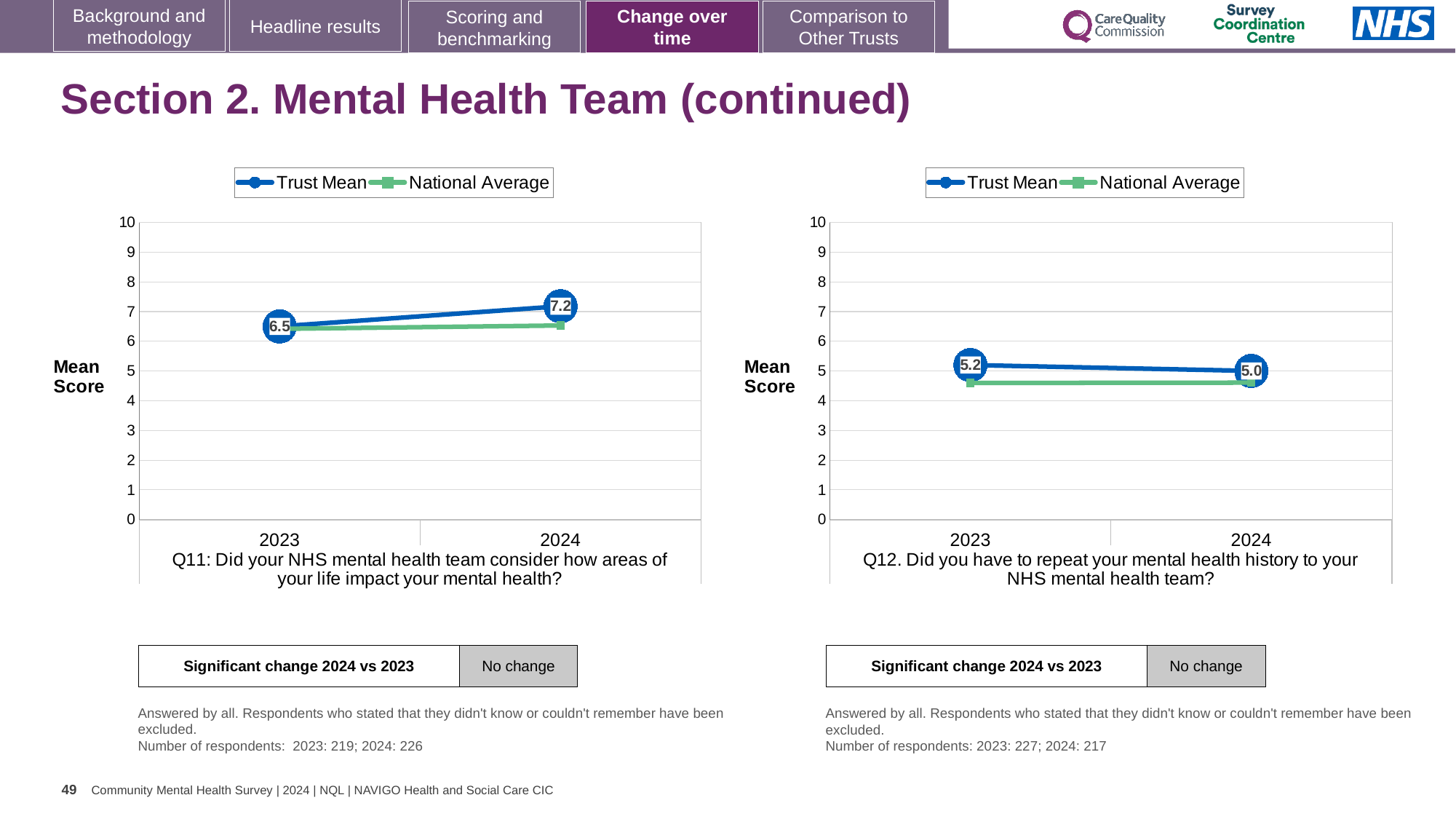
In the Q12 chart on the right, does the Trust Mean rise or fall from 2023 to 2024? fall In the Q11 chart on the left, which series has the higher value in 2024, Trust Mean or National Average? Trust Mean In the Q11 chart on the left, what is the Trust Mean value for 2023? 6.5 In the Q12 chart on the right, what is the Trust Mean value for 2023? 5.2 In the Q12 chart on the right, what is the difference between the Trust Mean in 2023 and in 2024? 0.2 In the Q12 chart on the right, what is the Trust Mean value for 2024? 5.0 In the Q11 chart on the left, by how much did the Trust Mean change from 2023 to 2024? 0.7 What type of chart is the Q11 chart on the left? line chart How many series does the legend of the Q12 chart on the right list? 2 In the Q11 chart on the left, what is the Trust Mean value for 2024? 7.2 In the Q11 chart on the left, does the Trust Mean rise or fall from 2023 to 2024? rise In the Q12 chart on the right, is the National Average value for 2024 greater or less than 5? less